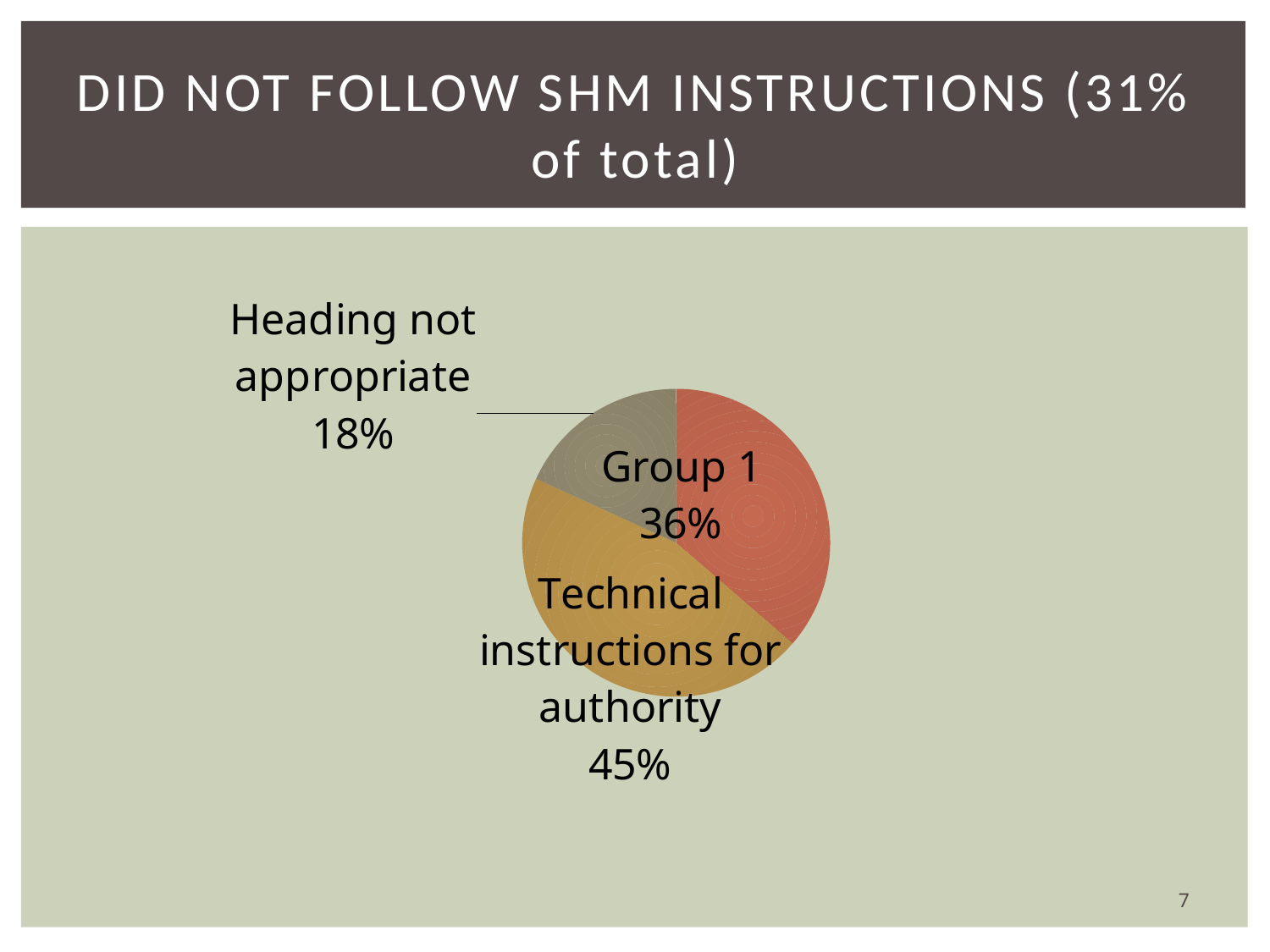
What is the difference in percentage points between "Group 1" and "Heading not appropriate"? 18 What colour is the "Group 1" slice of the pie? red What share of the pie does "Heading not appropriate" represent? 18% Which slice of the pie is the largest? Technical instructions for authority What share of the pie does "Technical instructions for authority" represent? 45% What kind of chart is shown on the slide? pie chart What is the difference in percentage points between "Technical instructions for authority" and "Group 1"? 9 Which is larger, the share for "Group 1" or the share for "Heading not appropriate"? Group 1 What is the title of the slide containing the pie chart? DID NOT FOLLOW SHM INSTRUCTIONS (31% of total) What share of the pie does "Group 1" represent? 36% Which slice of the pie is the smallest? Heading not appropriate How many slices does the pie chart have? 3